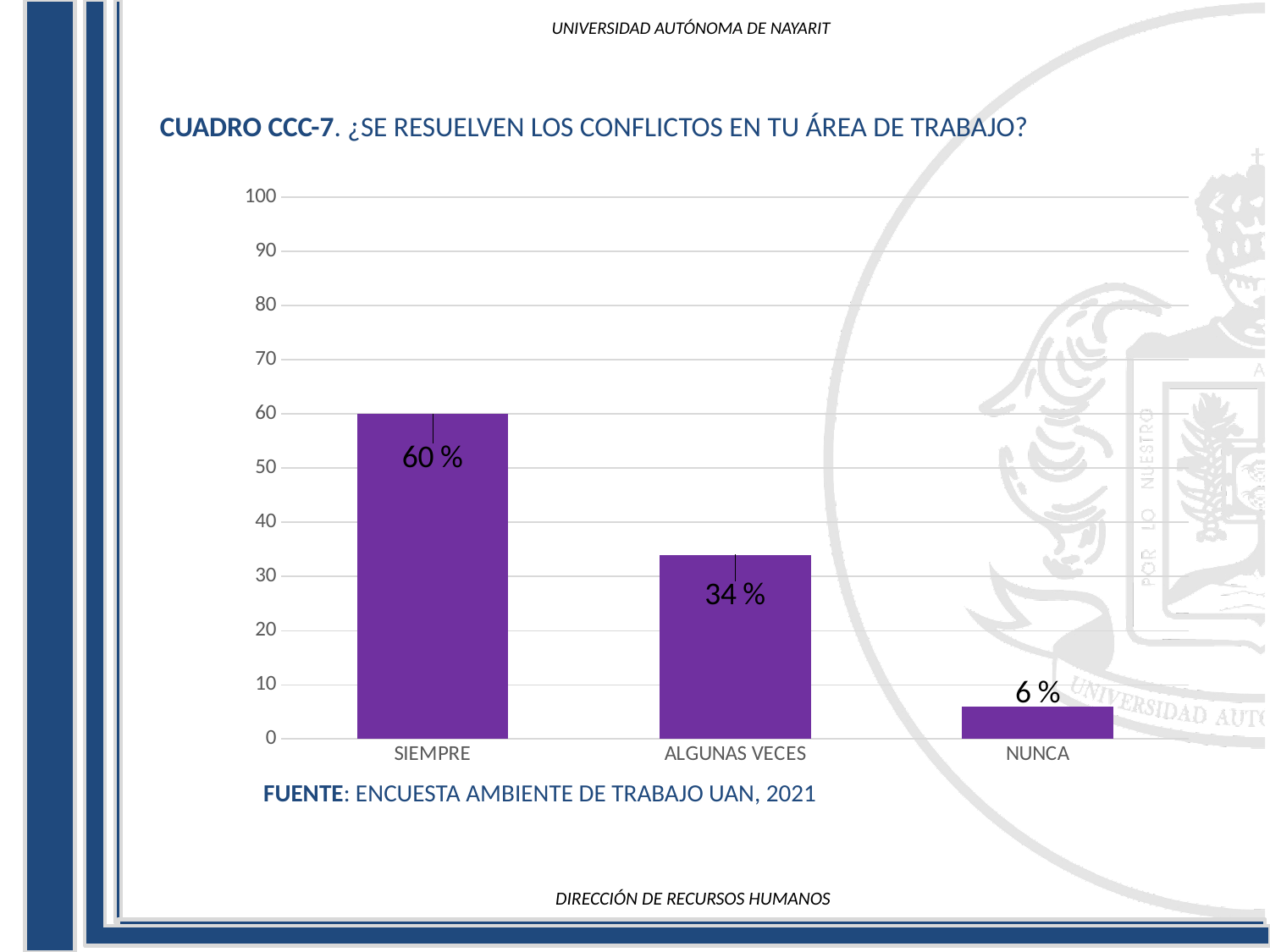
What source is cited below the chart? ENCUESTA AMBIENTE DE TRABAJO UAN, 2021 What is the value for SIEMPRE? 60 % Which is larger, the value for ALGUNAS VECES or the value for NUNCA? ALGUNAS VECES What is the value for NUNCA? 6 % How many categories are shown on the x axis? 3 What kind of chart is shown on the slide? bar chart What is the difference between the values for ALGUNAS VECES and NUNCA? 28 % What is the value for ALGUNAS VECES? 34 % Is the value for ALGUNAS VECES greater or less than 40? less What is the difference between the values for SIEMPRE and ALGUNAS VECES? 26 % Which category has the highest value? SIEMPRE Which category has the lowest value? NUNCA